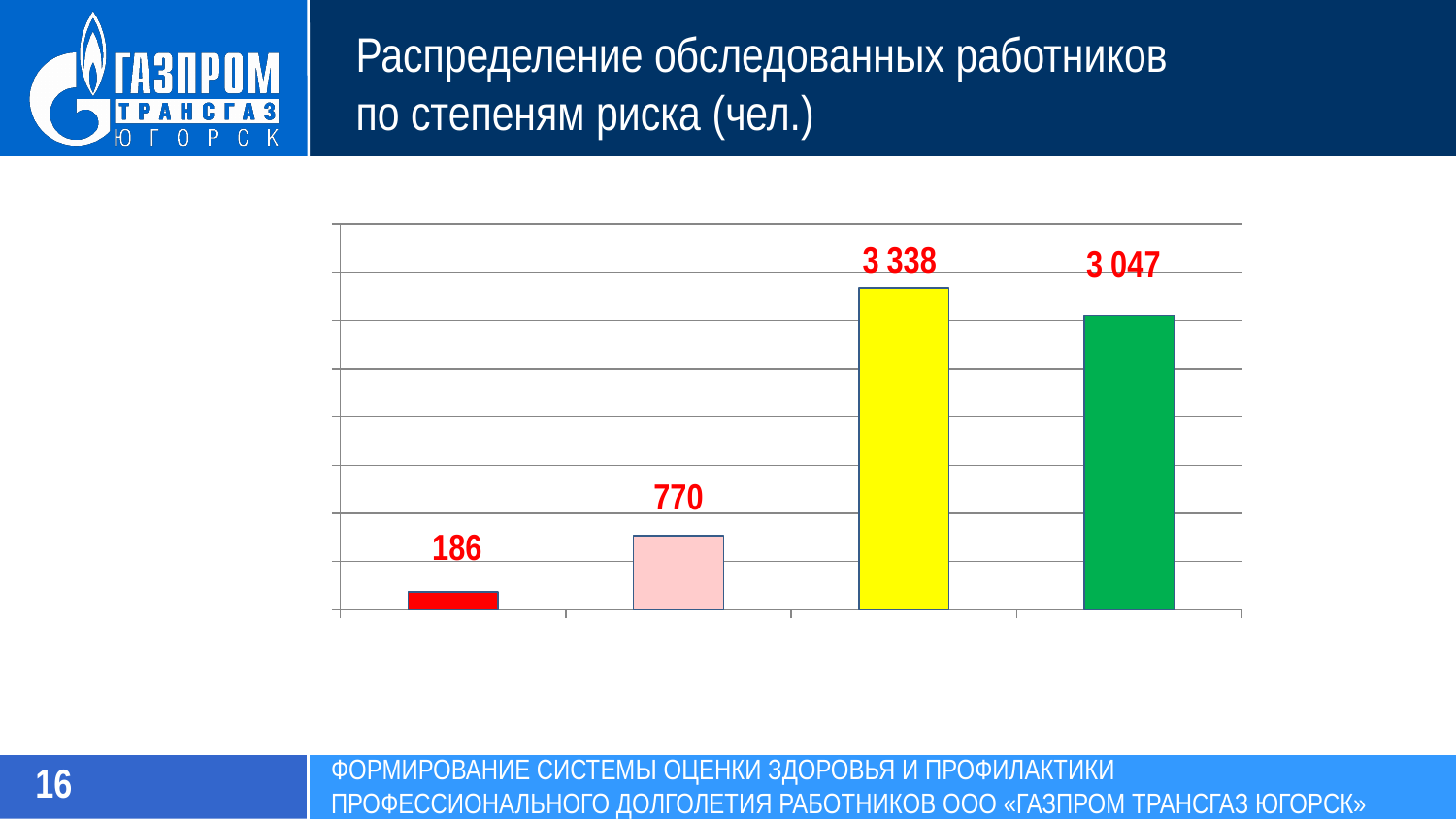
What is the title of the chart on the slide? Распределение обследованных работников по степеням риска (чел.) What is the difference between the values of the yellow bar and the green bar? 291 What is the value shown on the yellow bar (the third bar from the left)? 3 338 Which is larger, the value of the yellow bar or the value of the green bar? the yellow bar Which bar has the highest value? the yellow bar (3 338) What kind of chart is shown on the slide? bar chart What is the value shown on the red bar (the first bar from the left)? 186 Which bar has the lowest value? the red bar (186) What is the value shown on the pink bar (the second bar from the left)? 770 How many bars does the chart contain? 4 What is the value shown on the green bar (the fourth bar from the left)? 3 047 What is the difference between the values of the pink bar and the red bar? 584